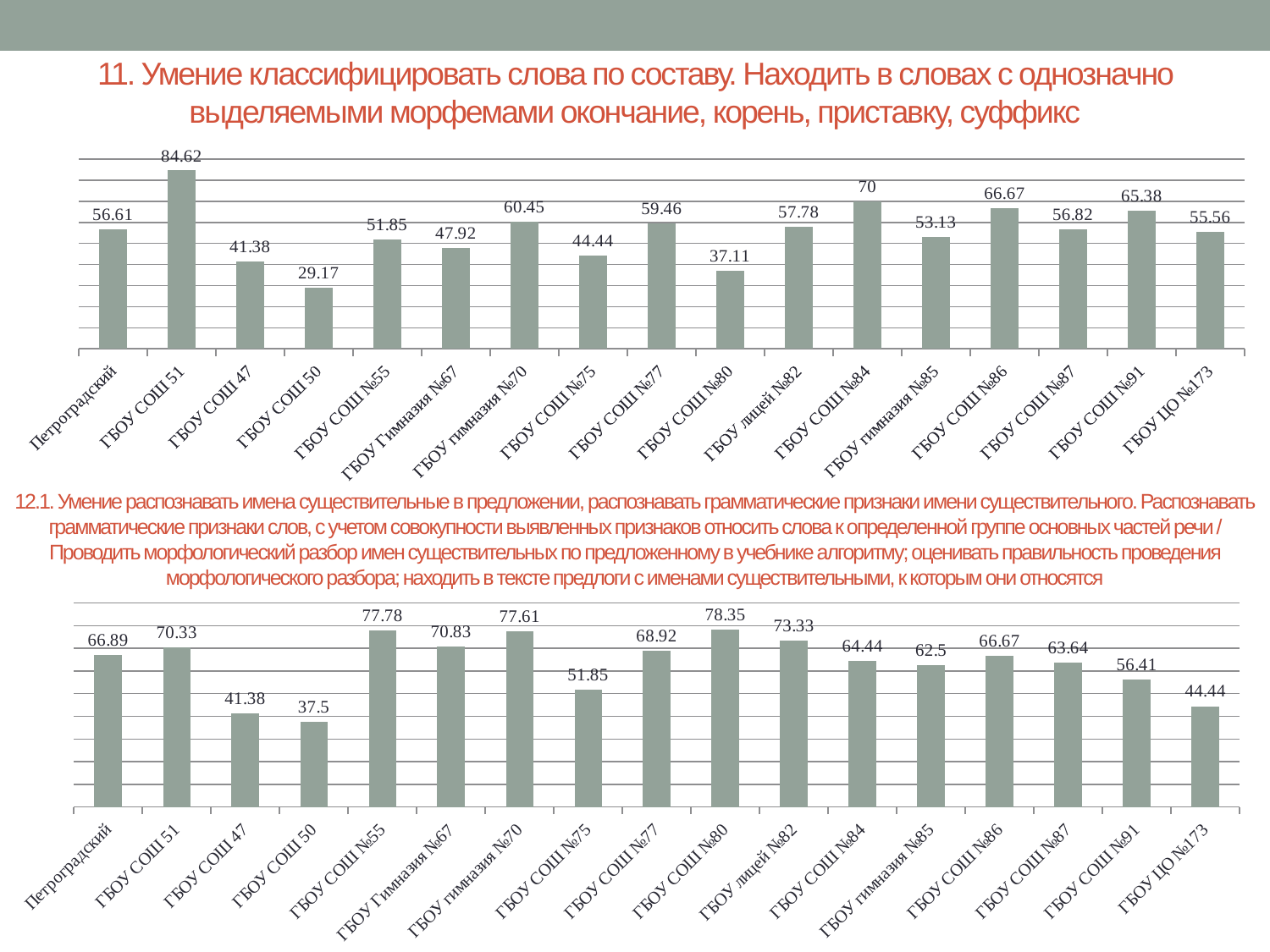
In the bottom chart (12.1. Умение распознавать имена существительные), what is the value for ГБОУ СОШ №80? 78.35 In the top chart (11. Умение классифицировать слова по составу), what is the value for ГБОУ СОШ 51? 84.62 In the top chart (11. Умение классифицировать слова по составу), what is the value for ГБОУ СОШ №84? 70 What type of chart is the top chart (11. Умение классифицировать слова по составу)? Bar chart In the top chart (11. Умение классифицировать слова по составу), which category has the lowest value? ГБОУ СОШ 50 In the bottom chart (12.1. Умение распознавать имена существительные), which category has the highest value? ГБОУ СОШ №80 How many categories are shown in the bottom chart (12.1. Умение распознавать имена существительные)? 17 In the top chart (11. Умение классифицировать слова по составу), which category has the highest value? ГБОУ СОШ 51 In the bottom chart (12.1. Умение распознавать имена существительные), what is the difference between the values for Петроградский and ГБОУ ЦО №173? 22.45 In the top chart (11. Умение классифицировать слова по составу), which is larger: the value for ГБОУ гимназия №70 or ГБОУ СОШ №77? ГБОУ гимназия №70 In the bottom chart (12.1. Умение распознавать имена существительные), which category has the lowest value? ГБОУ СОШ 50 In the top chart (11. Умение классифицировать слова по составу), what is the difference between the values for ГБОУ СОШ 51 and ГБОУ СОШ 50? 55.45